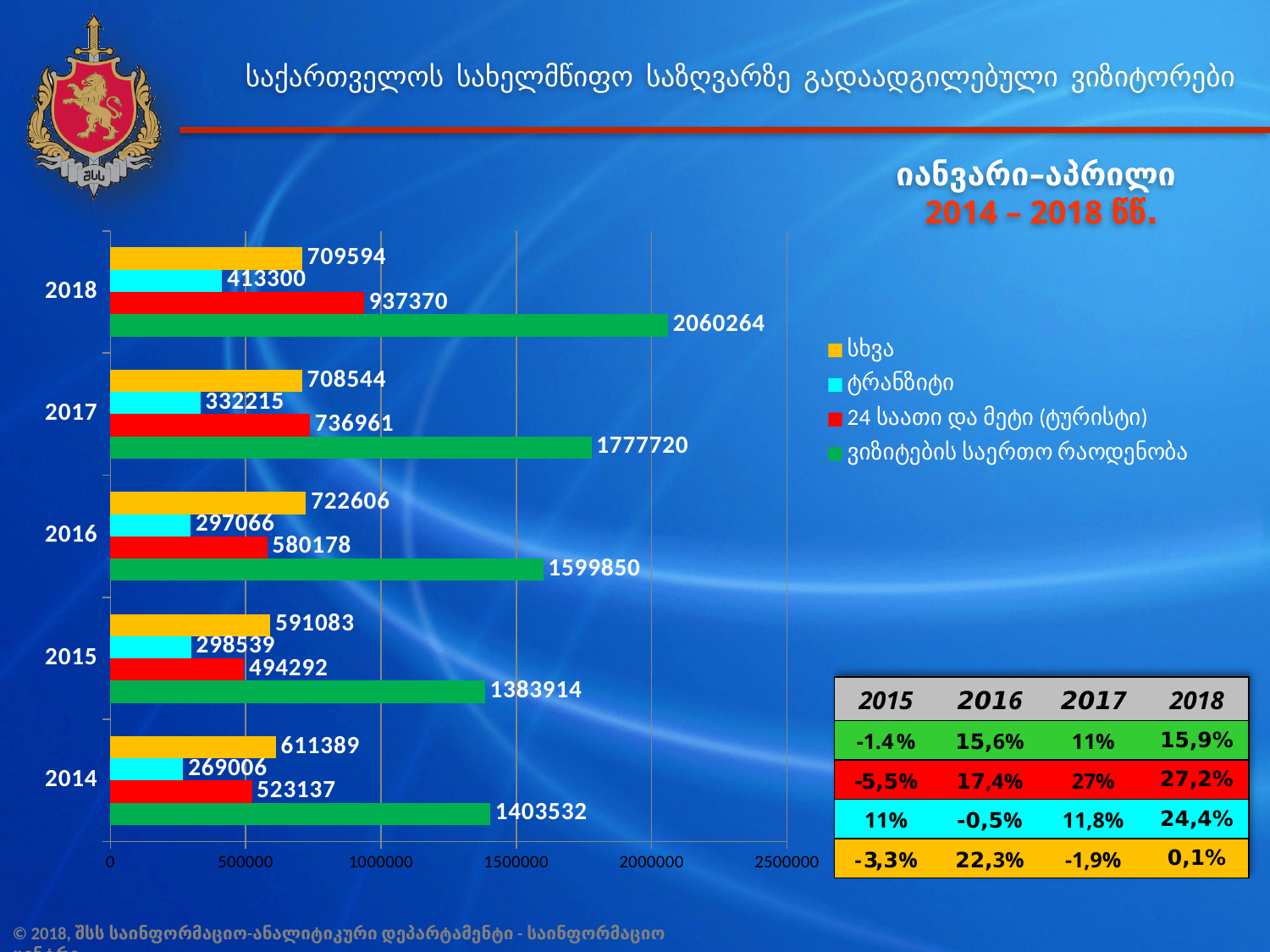
Is the value of 24 საათი და მეტი (ტურისტი) for 2017 greater or less than 500000? greater Which year has the highest value for ვიზიტების საერთო რაოდენობა? 2018 What is the value of ტრანზიტი for 2016? 297066 Which year has the lowest value for ტრანზიტი? 2014 What is the value of ვიზიტების საერთო რაოდენობა for 2018? 2060264 How many years are shown on the chart? 5 What is the value of 24 საათი და მეტი (ტურისტი) for 2014? 523137 What is the value of სხვა for 2017? 708544 Which is larger: the სხვა value for 2016 or the სხვა value for 2015? 2016 What is the difference between the ვიზიტების საერთო რაოდენობა values for 2018 and 2017? 282544 What type of chart is shown on the slide? bar chart How many series does the legend list? 4